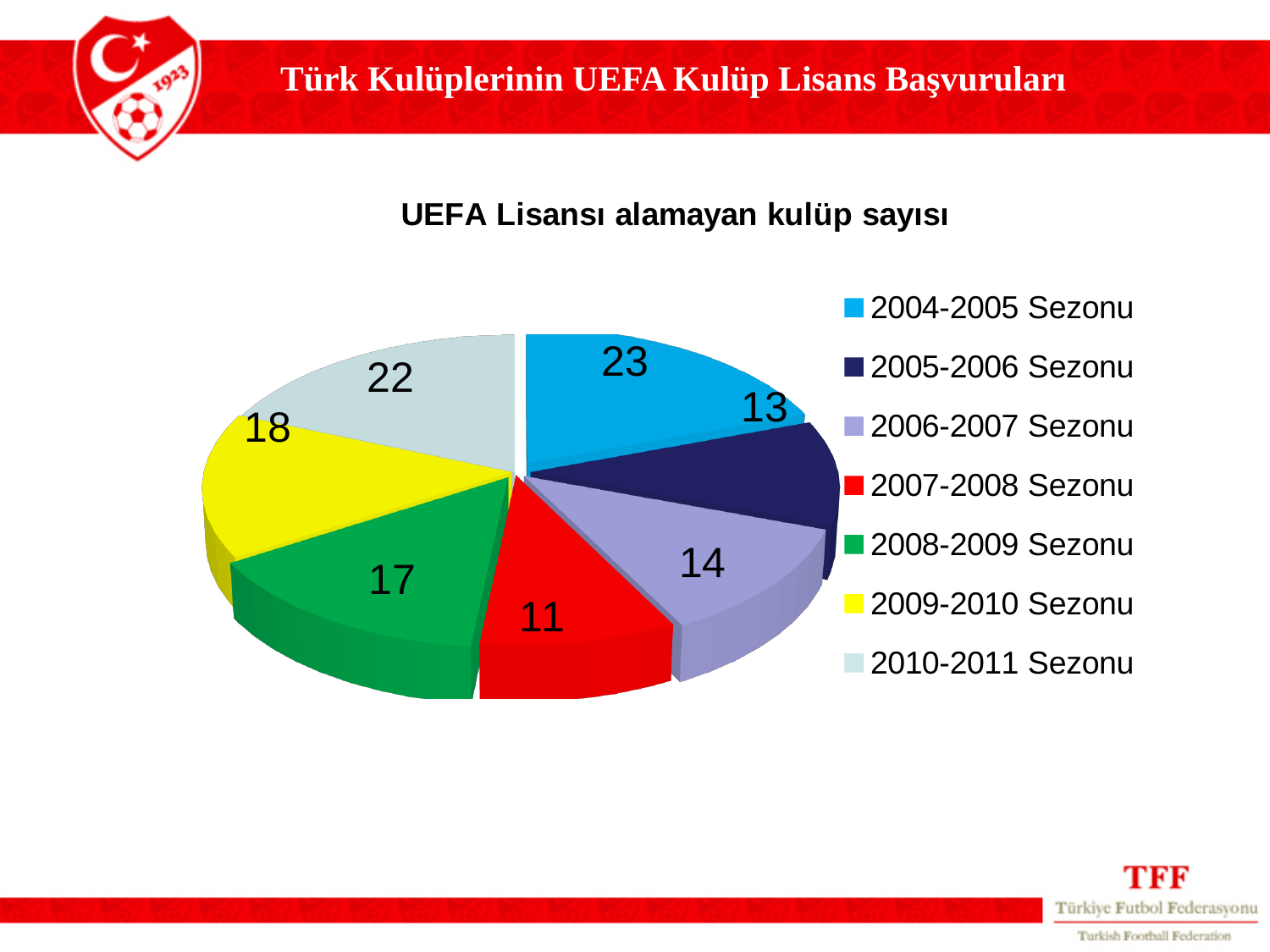
What is the value for the 2004-2005 Sezonu slice? 23 How many seasons does the legend list? 7 What kind of chart is shown on the slide? pie chart What is the title of the chart? UEFA Lisansı alamayan kulüp sayısı What is the value for the 2007-2008 Sezonu slice? 11 Which season has the highest value? 2004-2005 Sezonu What is the value for the 2010-2011 Sezonu slice? 22 What is the value for the 2008-2009 Sezonu slice? 17 Which is larger, the value for 2009-2010 Sezonu or the value for 2006-2007 Sezonu? 2009-2010 Sezonu What is the difference between the values for 2004-2005 Sezonu and 2007-2008 Sezonu? 12 Which season has the lowest value? 2007-2008 Sezonu What colour is the slice for 2009-2010 Sezonu? yellow